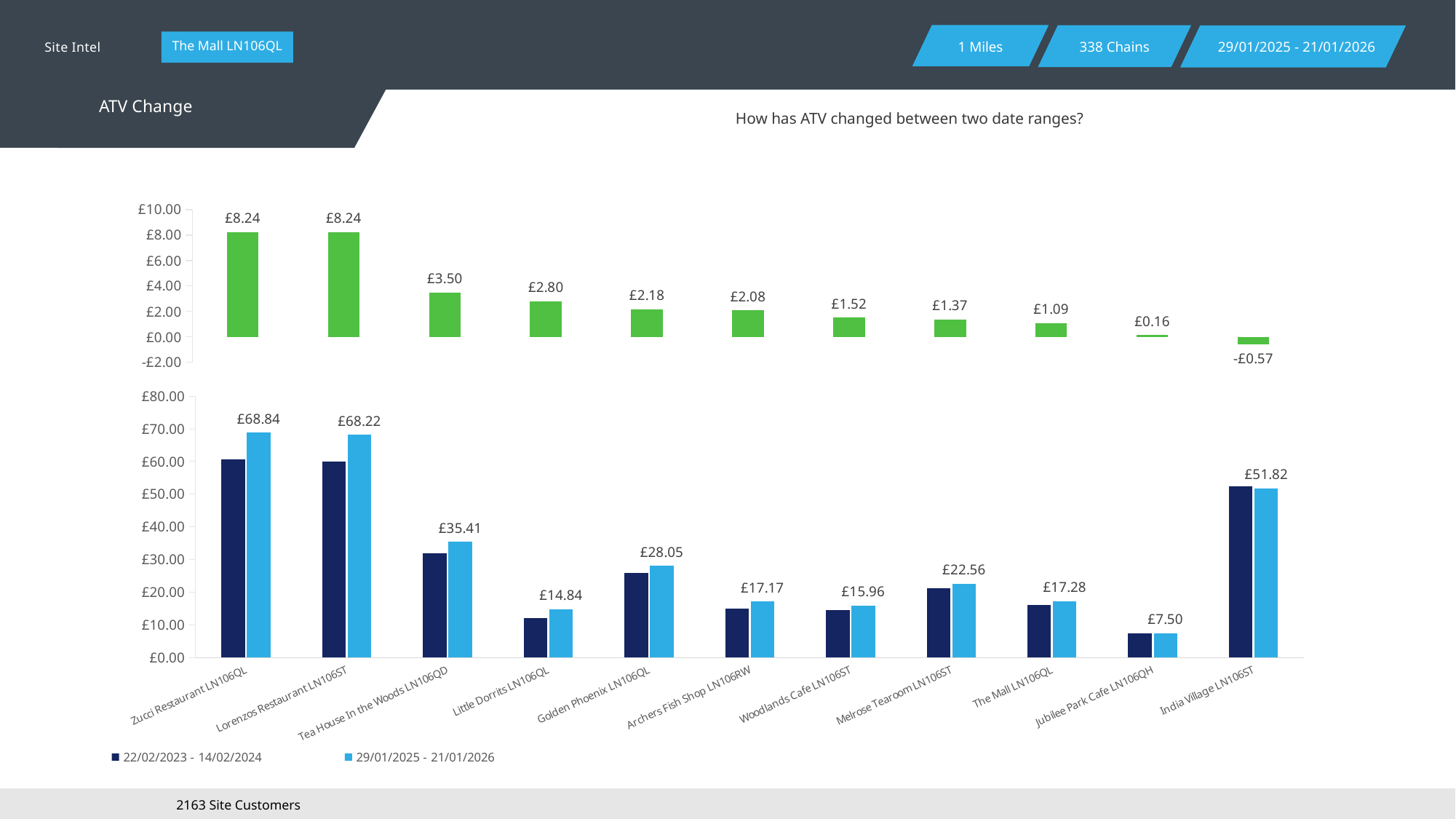
In the bottom chart, which has the larger 29/01/2025 - 21/01/2026 value: Melrose Tearoom LN106ST or The Mall LN106QL? Melrose Tearoom LN106ST What are the two legend entries of the bottom chart? 22/02/2023 - 14/02/2024 and 29/01/2025 - 21/01/2026 What kind of chart is the bottom chart? bar chart In the top chart (ATV change), how many categories are plotted? 11 In the bottom chart, what is the value for Golden Phoenix LN106QL in the 29/01/2025 - 21/01/2026 series? £28.05 In the top chart (ATV change), what is the difference between the values for Little Dorrits LN106QL and Golden Phoenix LN106QL? £0.62 In the top chart (ATV change), what is the value for Tea House In the Woods LN106QD? £3.50 In the bottom chart, what is the value for Jubilee Park Cafe LN106QH in the 29/01/2025 - 21/01/2026 series? £7.50 In the top chart (ATV change), which category has the lowest value? India Village LN106ST In the bottom chart, is the 22/02/2023 - 14/02/2024 value for Golden Phoenix LN106QL greater or less than £20.00? greater In the bottom chart, how many series does the legend list? 2 In the bottom chart, what is the difference between the 29/01/2025 - 21/01/2026 values for Zucci Restaurant LN106QL and Lorenzos Restaurant LN106ST? £0.62